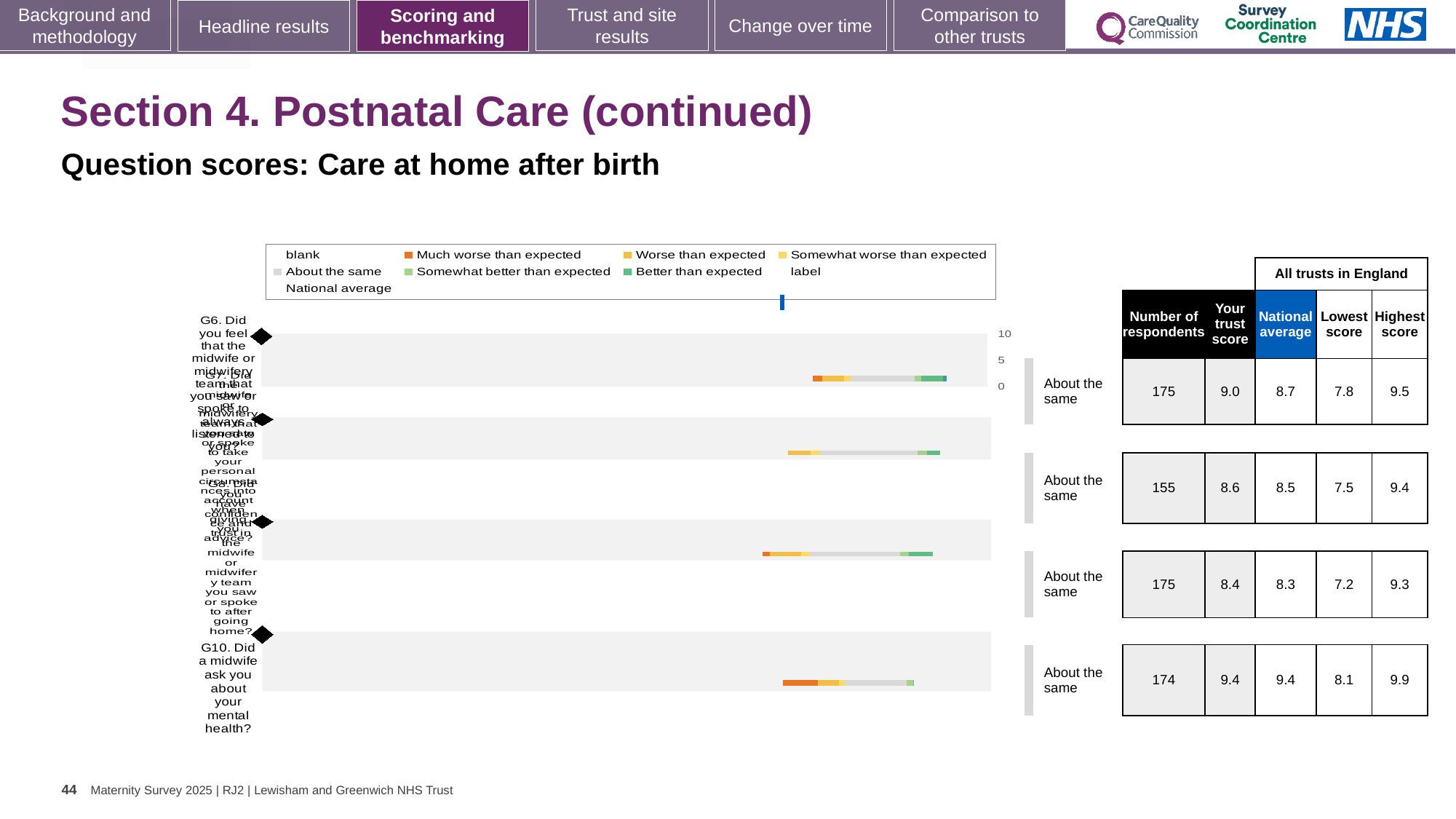
How many question rows (bars) are plotted in the chart? 4 For the top row (G6), which is larger: the trust score or the national average? the trust score (9.0) What benchmark category label is shown next to each of the four rows? About the same What is the number of respondents for the first (top) row, question G6? 175 What kind of chart is shown on the slide? bar chart Which row has the highest 'Your trust score'? G10 (bottom row), 9.4 Which row has the lowest 'Your trust score'? the third row, 8.4 What is the trust score for the bottom row, question G10 about mental health? 9.4 What is the lowest score across all trusts in England for the second row? 7.5 Which legend entry is shown in dark orange? Much worse than expected What is the highest score across all trusts in England for the bottom row (G10)? 9.9 For the top row (G6), what is the difference between the trust score and the national average? 0.3